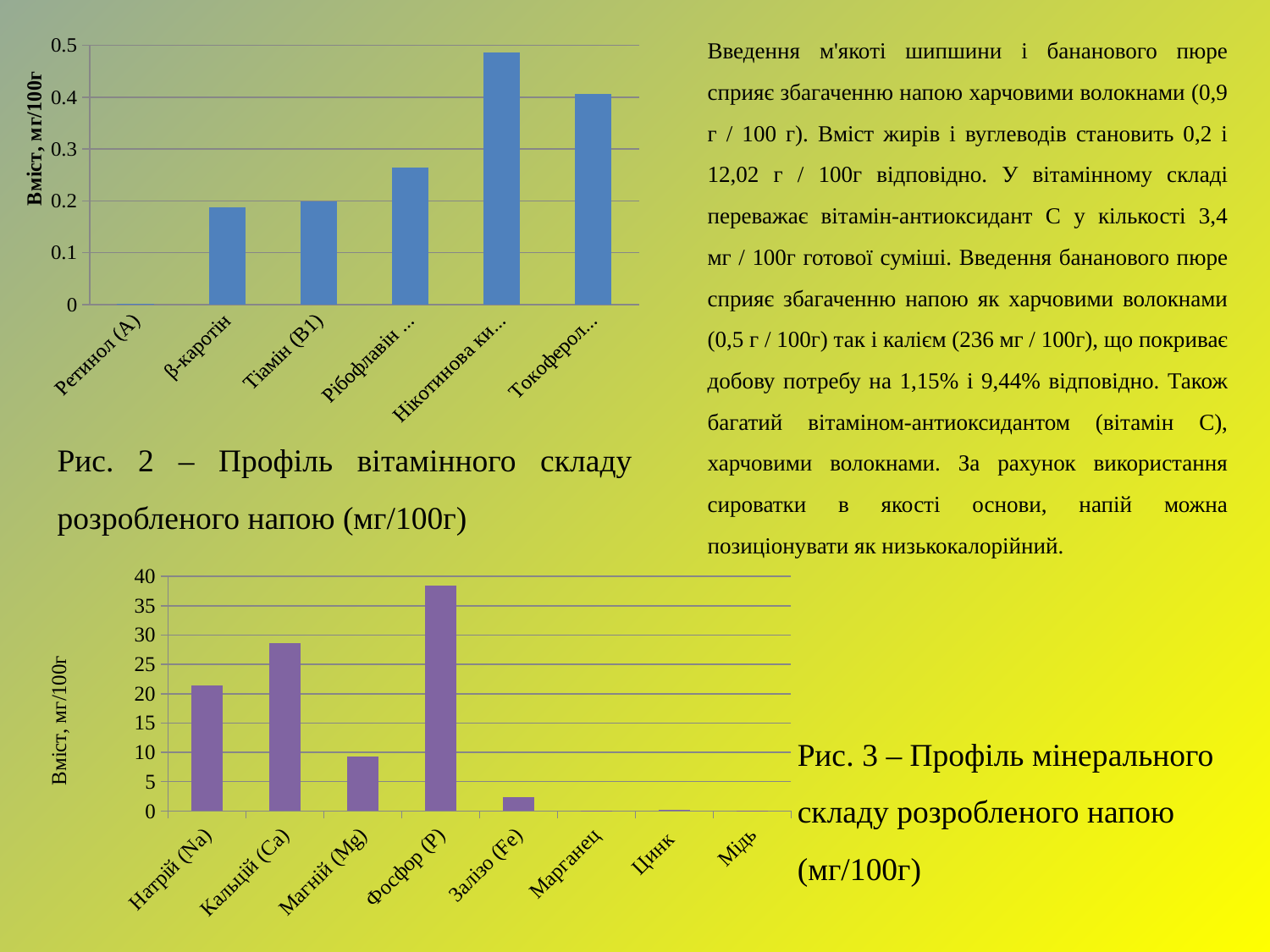
What is the y-axis label of Рис. 2 (Профіль вітамінного складу)? Вміст, мг/100г In Рис. 2 (Профіль вітамінного складу), is the value for Нікотинова ки... greater or less than 0.4? greater In Рис. 2 (Профіль вітамінного складу), which category has the highest value? Нікотинова ки... In Рис. 3 (Профіль мінерального складу), which is larger, the value for Кальцій (Ca) or the value for Натрій (Na)? Кальцій (Ca) In Рис. 2 (Профіль вітамінного складу), is the value for β-каротін greater or less than 0.2? less How many categories are shown on the x axis of Рис. 2 (Профіль вітамінного складу)? 6 What kind of chart is Рис. 2 (Профіль вітамінного складу)? bar chart How many categories are shown on the x axis of Рис. 3 (Профіль мінерального складу)? 8 In Рис. 3 (Профіль мінерального складу), is the value for Фосфор (P) greater or less than 35? greater In Рис. 2 (Профіль вітамінного складу), which is larger, the value for Рібофлавін ... or the value for Тіамін (B1)? Рібофлавін ... In Рис. 3 (Профіль мінерального складу), which category has the highest value? Фосфор (P)